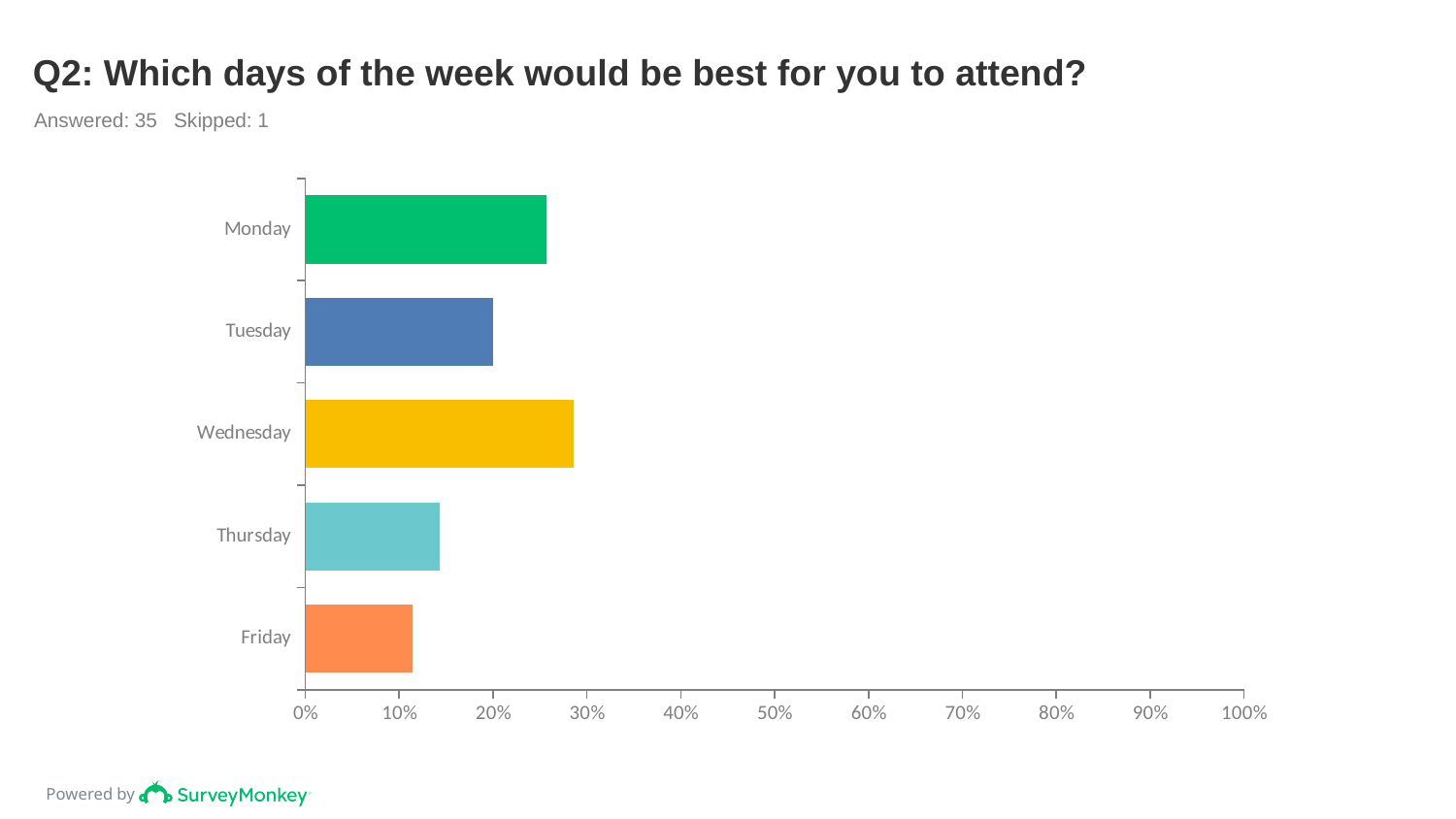
Which is larger, the value for Monday or the value for Tuesday? Monday Is the value for Friday greater or less than 20%? less What kind of chart is shown on the slide? bar chart How many respondents answered the question shown in the chart title? 35 What is the value for Tuesday? 20% Is the value for Monday greater or less than 20%? greater Which day has the highest percentage in the chart? Wednesday Which is larger, the value for Thursday or the value for Friday? Thursday Which day has the lowest percentage in the chart? Friday Is the value for Thursday greater or less than 10%? greater How many days of the week are shown as categories in the chart? 5